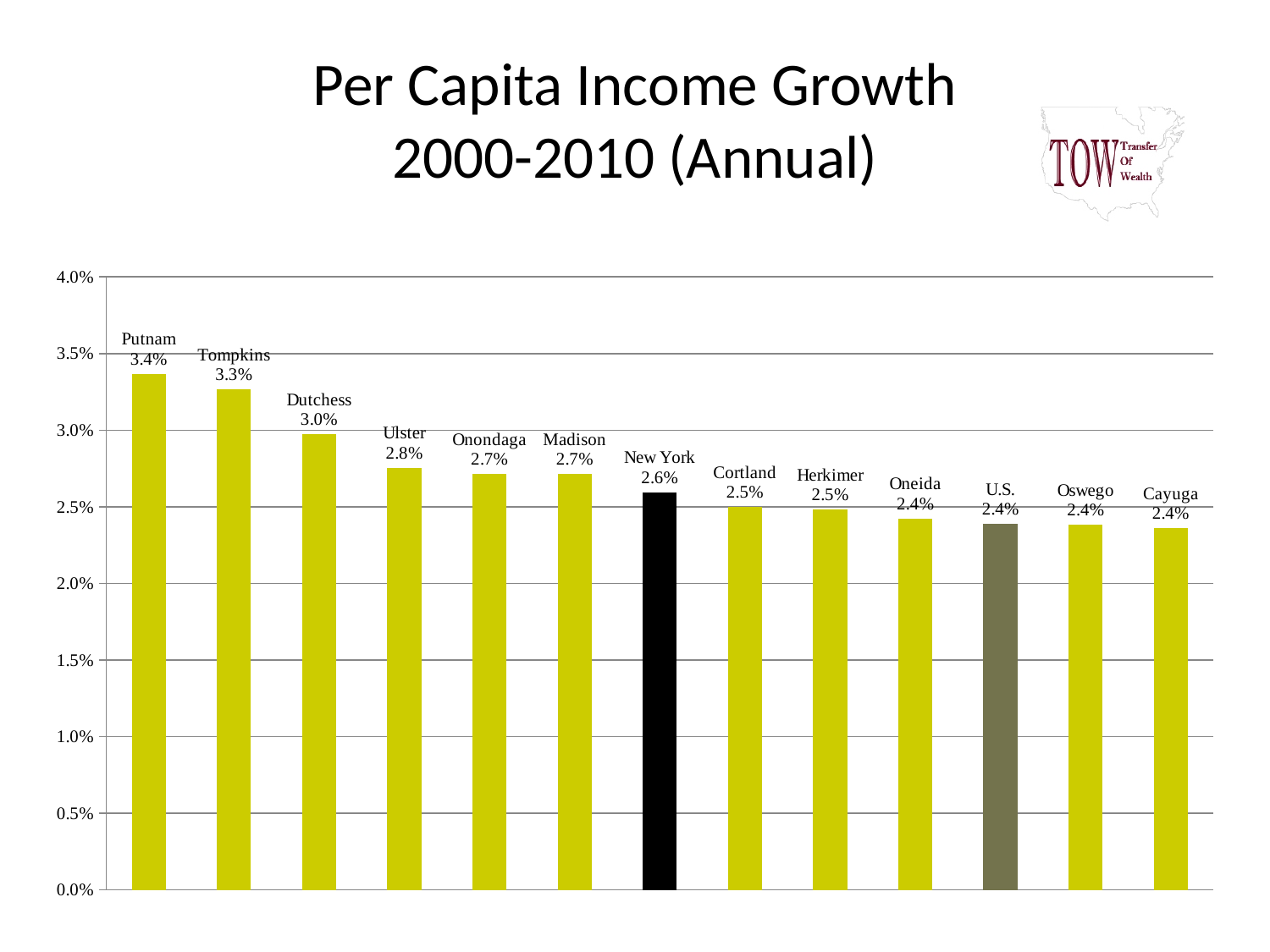
What is the per capita income growth value for Putnam? 3.4% What kind of chart is shown on the slide? bar chart What is the per capita income growth value for Dutchess? 3.0% Which has a larger value, Dutchess or Ulster? Dutchess Is the value for Cayuga greater or less than 2.5%? less What is the per capita income growth value for New York? 2.6% What is the per capita income growth value for the U.S.? 2.4% Do the values rise or fall from left to right across the chart? fall How many bars are shown in the chart? 13 What is the difference between the values for Putnam and New York? 0.8 percentage points What is the difference between the values for Putnam and Dutchess? 0.4 percentage points Which category has the highest per capita income growth? Putnam